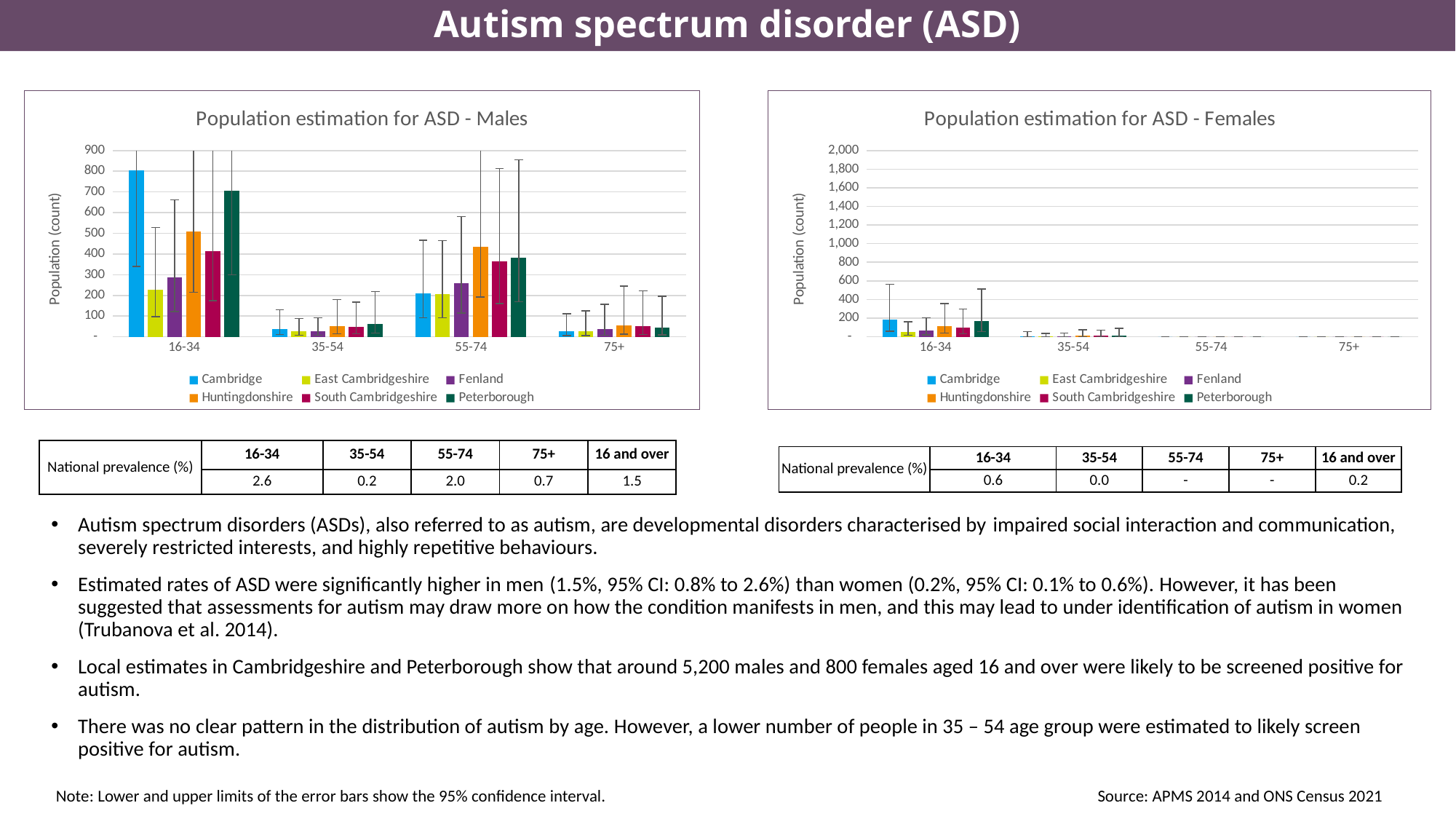
In the 'Population estimation for ASD - Males' chart, which is larger in the 16-34 age group: Cambridge or East Cambridgeshire? Cambridge In the 'Population estimation for ASD - Males' chart, which area has the highest value in the 16-34 age group? Cambridge In the 'Population estimation for ASD - Females' chart, is the value for Cambridge in the 16-34 age group greater or less than 400? less How many age-group categories are shown on the x axis of the 'Population estimation for ASD - Males' chart? 4 In the 'Population estimation for ASD - Males' chart, is the value for Fenland in the 16-34 age group greater or less than 400? less What is the title of the chart on the right side of the slide? Population estimation for ASD - Females How many series does the legend of the 'Population estimation for ASD - Females' chart list? 6 In the 'Population estimation for ASD - Males' chart, is the value for Huntingdonshire in the 55-74 age group greater or less than 300? greater What is the label of the y axis on the 'Population estimation for ASD - Females' chart? Population (count) What type of chart is the 'Population estimation for ASD - Males' chart? bar chart